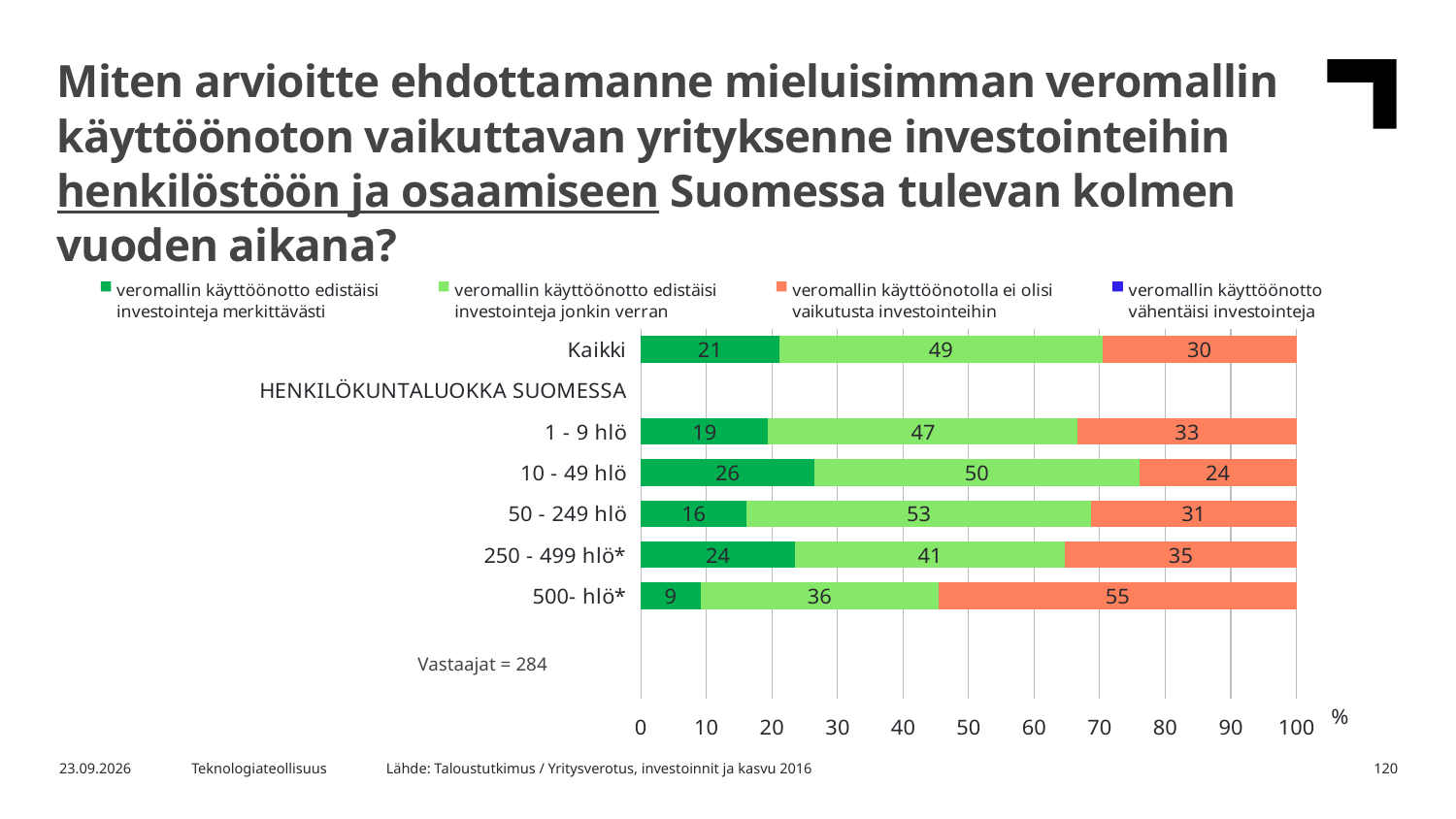
What is the total of the stacked bar for 1 - 9 hlö? 99 Which category has the lowest value for 'veromallin käyttöönotto edistäisi investointeja jonkin verran'? 500- hlö* What is the value for 'veromallin käyttöönotto edistäisi investointeja merkittävästi' in the Kaikki bar? 21 What is the number of respondents (Vastaajat) shown on the slide? 284 What kind of chart is shown on the slide? stacked bar chart What is the value for 'veromallin käyttöönotto edistäisi investointeja jonkin verran' in the 50 - 249 hlö bar? 53 What is the difference between the 'veromallin käyttöönotolla ei olisi vaikutusta investointeihin' values for 500- hlö* and 10 - 49 hlö? 31 Which category has the highest value for 'veromallin käyttöönotto edistäisi investointeja merkittävästi'? 10 - 49 hlö How many series does the legend list? 4 What is the value for 'veromallin käyttöönotolla ei olisi vaikutusta investointeihin' in the 500- hlö* bar? 55 Which is larger: the 'veromallin käyttöönotto edistäisi investointeja merkittävästi' value for 250 - 499 hlö* or for 1 - 9 hlö? 250 - 499 hlö* How many categories (bars) are plotted in the chart? 6